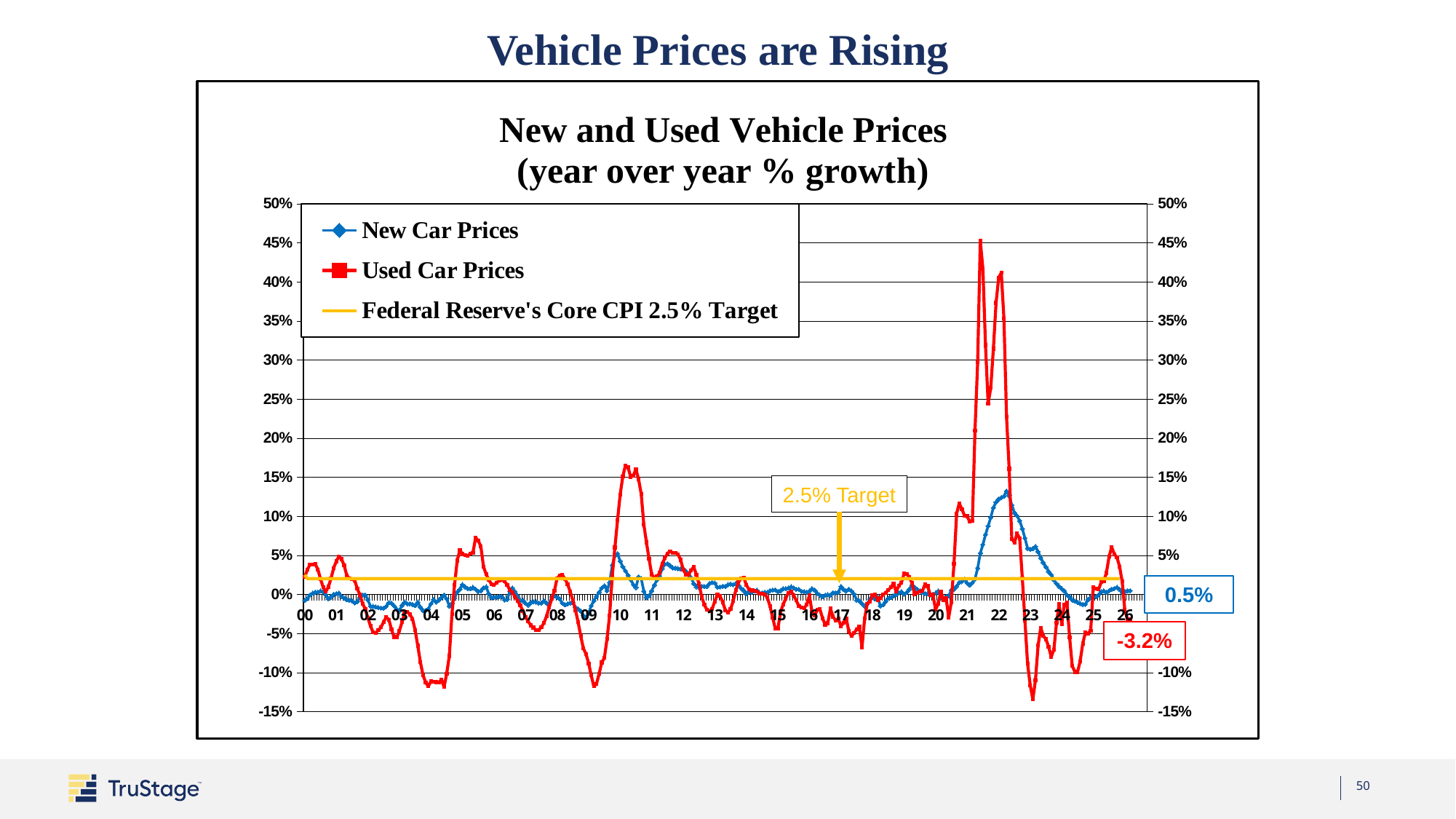
Which is larger at the latest labelled point, New Car Prices or Used Car Prices? New Car Prices Is the peak of Used Car Prices around 2021 greater or less than 40%? greater What is the difference between the latest labelled New Car Prices value (0.5%) and the latest labelled Used Car Prices value (-3.2%)? 3.7 percentage points Is the lowest point of Used Car Prices around 2023 greater or less than -10%? less What kind of chart is shown on the slide? line chart What is the title of the chart? New and Used Vehicle Prices (year over year % growth) What is the latest labelled value for Used Car Prices? -3.2% Which series reaches the highest value on the chart? Used Car Prices What is the Federal Reserve's Core CPI target shown on the chart? 2.5% Is the peak of New Car Prices around 2022 greater or less than 10%? greater What is the latest labelled value for New Car Prices? 0.5% How many series does the legend list? 3